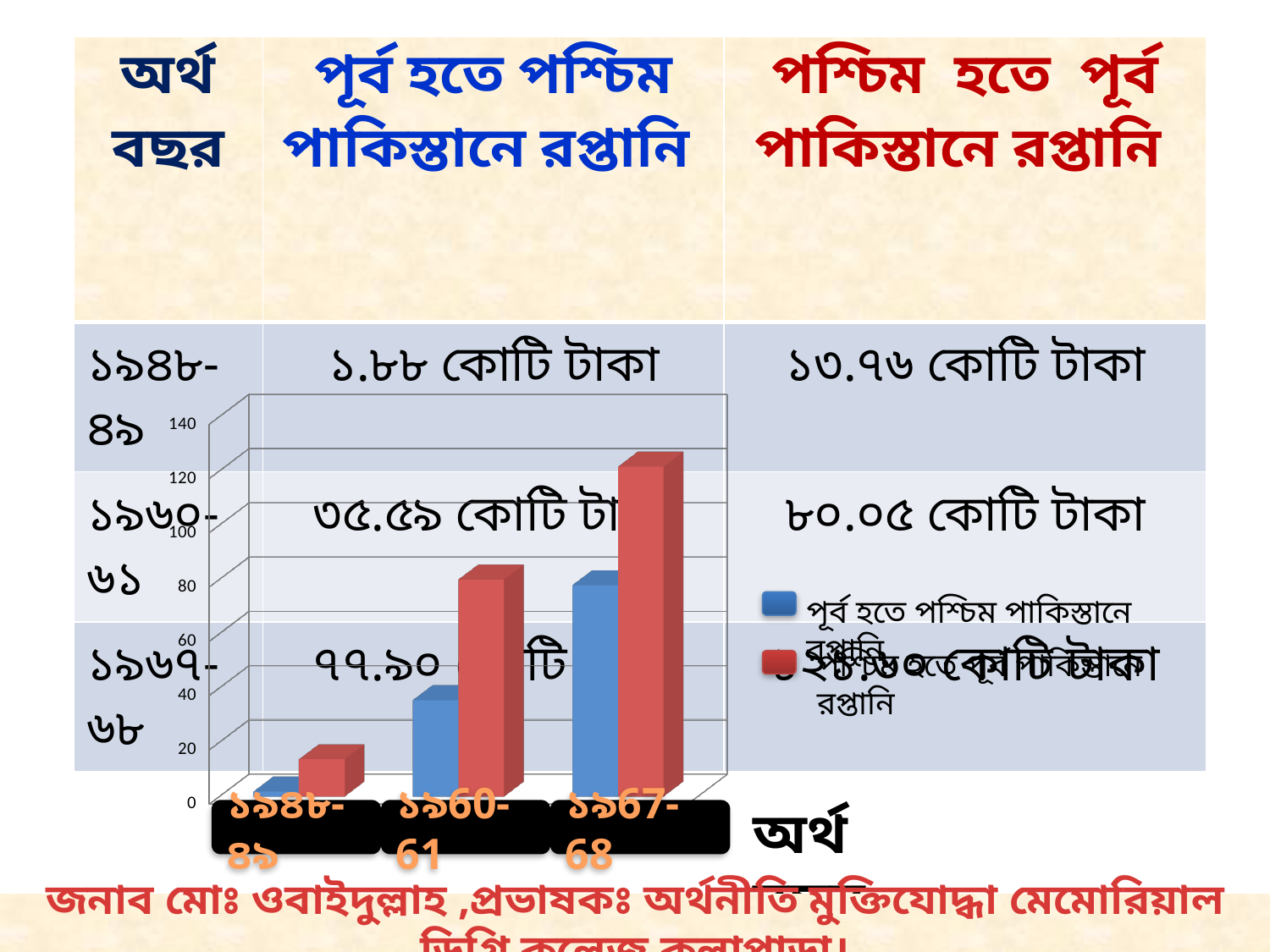
How many fiscal-year categories are plotted on the x axis of the chart? 3 In ১৯৬০-৬১, which series has the larger bar: পূর্ব হতে পশ্চিম পাকিস্তানে রপ্তানি or পশ্চিম হতে পূর্ব পাকিস্তানে রপ্তানি? পশ্চিম হতে পূর্ব পাকিস্তানে রপ্তানি Is the value for পশ্চিম হতে পূর্ব পাকিস্তানে রপ্তানি in ১৯৬৭-৬৮ greater or less than 100? greater Do the bars for পশ্চিম হতে পূর্ব পাকিস্তানে রপ্তানি rise or fall from ১৯৪৮-৪৯ to ১৯৬৭-৬৮? rise Which series and category has the shortest bar in the chart? পূর্ব হতে পশ্চিম পাকিস্তানে রপ্তানি, ১৯৪৮-৪৯ Which series and category has the tallest bar in the chart? পশ্চিম হতে পূর্ব পাকিস্তানে রপ্তানি, ১৯৬৭-৬৮ Is the value for পূর্ব হতে পশ্চিম পাকিস্তানে রপ্তানি in ১৯৬০-৬১ greater or less than 20? greater Is the value for পশ্চিম হতে পূর্ব পাকিস্তানে রপ্তানি in ১৯৪৮-৪৯ greater or less than 20? less What kind of chart is shown on the slide? bar chart What colour are the bars for the series পূর্ব হতে পশ্চিম পাকিস্তানে রপ্তানি? blue How many series does the chart legend list? 2